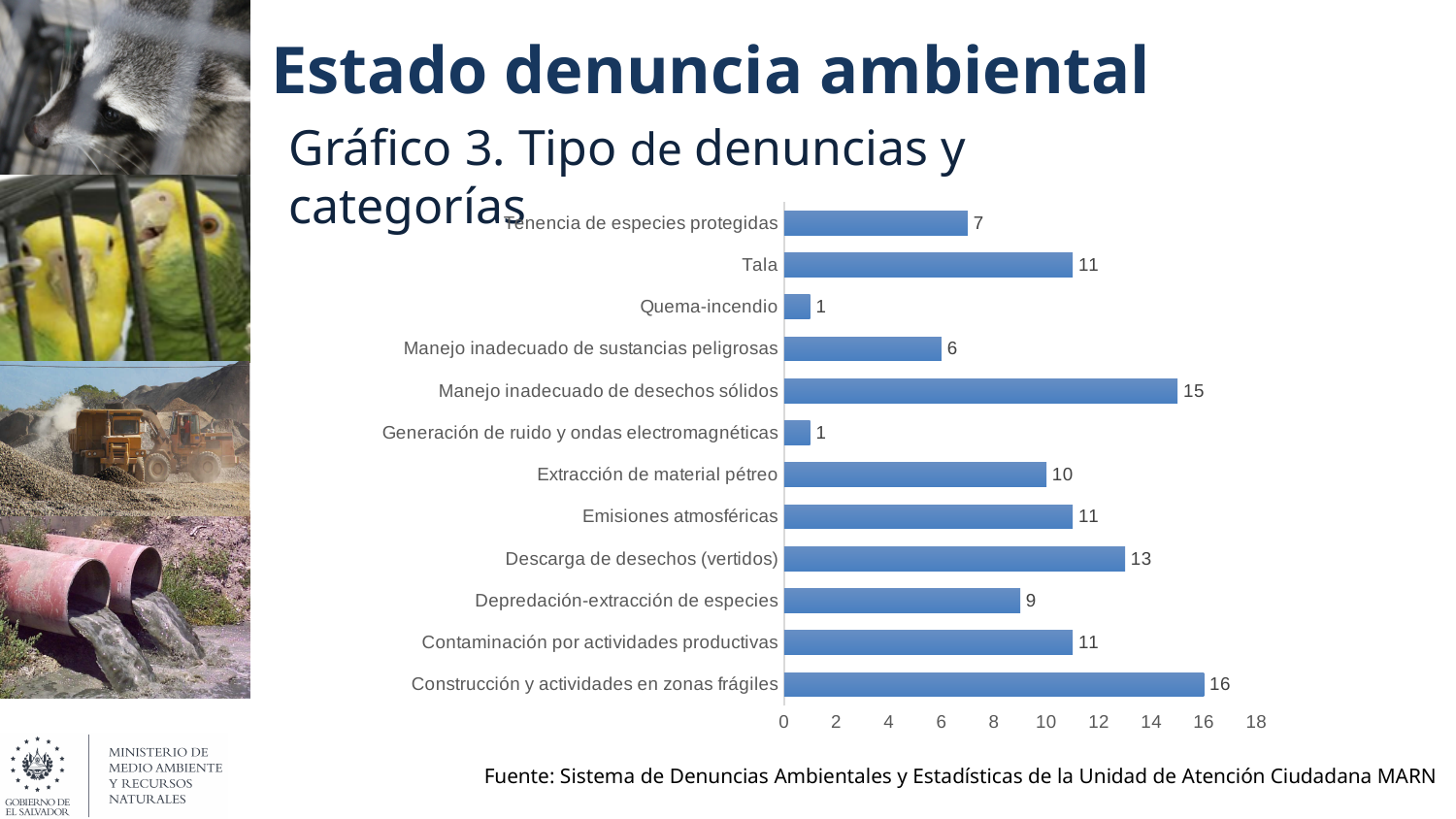
What is the value for Tenencia de especies protegidas? 7 Which is larger, the value for Extracción de material pétreo or the value for Manejo inadecuado de sustancias peligrosas? Extracción de material pétreo What is the title of the chart? Gráfico 3. Tipo de denuncias y categorías What is the lowest value shown in the chart? 1 What is the difference between the values for Construcción y actividades en zonas frágiles and Manejo inadecuado de desechos sólidos? 1 Which category has the highest value? Construcción y actividades en zonas frágiles What is the value for Construcción y actividades en zonas frágiles? 16 How many categories are shown in the chart? 12 What is the value for Manejo inadecuado de desechos sólidos? 15 What is the value for Descarga de desechos (vertidos)? 13 What is the difference between the values for Descarga de desechos (vertidos) and Depredación-extracción de especies? 4 What kind of chart is shown on the slide? Bar chart